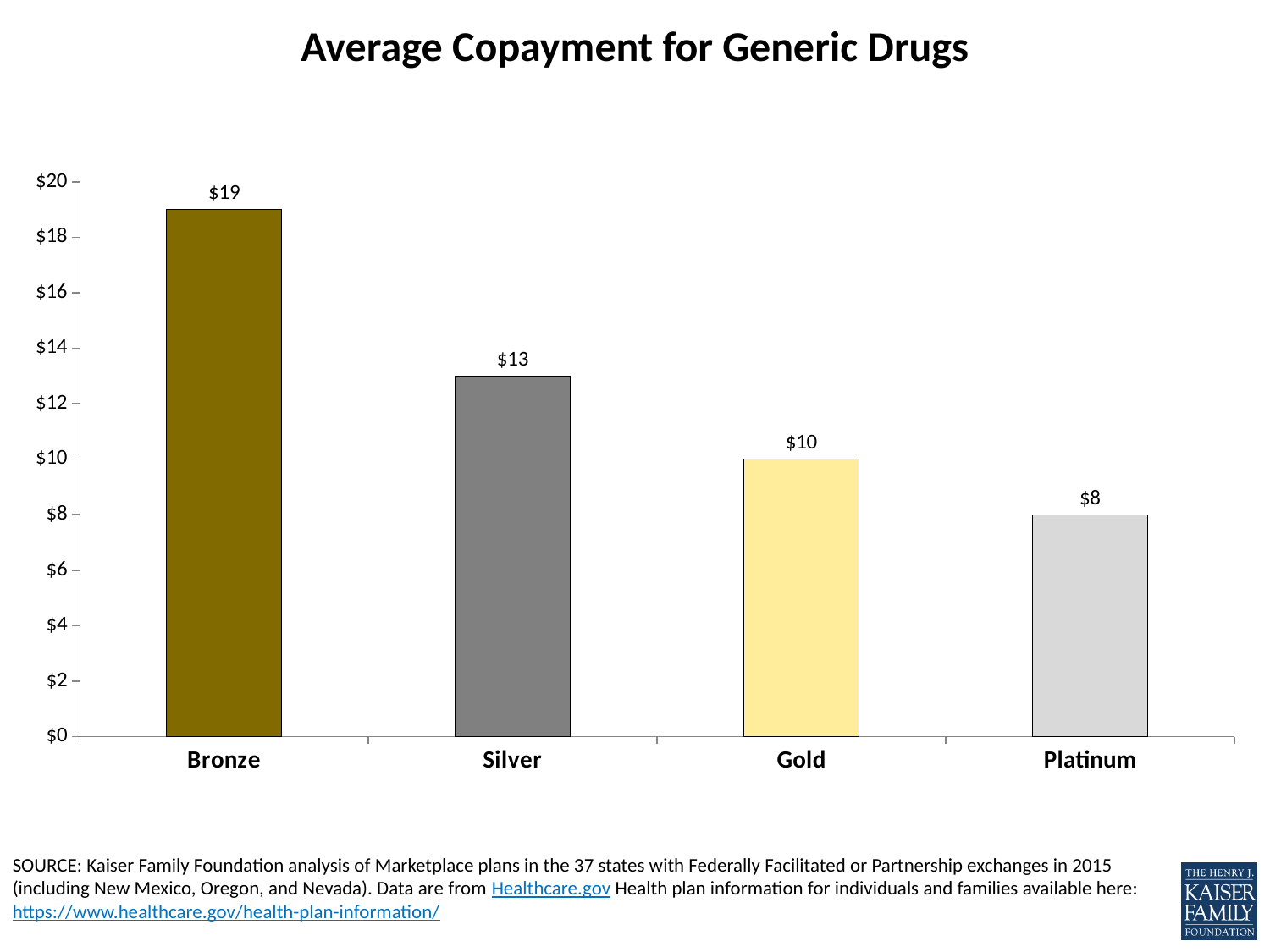
What is the difference between the average copayment for Gold and Platinum plans? $2 Do the average copayments rise or fall moving from Bronze to Platinum along the x axis? Fall Which plan type has the lowest average copayment for generic drugs? Platinum What is the difference between the average copayment for Bronze and Silver plans? $6 Which plan type has the highest average copayment for generic drugs? Bronze Which has a higher average copayment for generic drugs, Silver or Gold? Silver What is the average copayment for generic drugs for Gold plans? $10 What is the average copayment for generic drugs for Platinum plans? $8 What kind of chart is shown on the slide? Bar chart What is the average copayment for generic drugs for Bronze plans? $19 What is the average copayment for generic drugs for Silver plans? $13 How many plan types are shown in the chart? 4